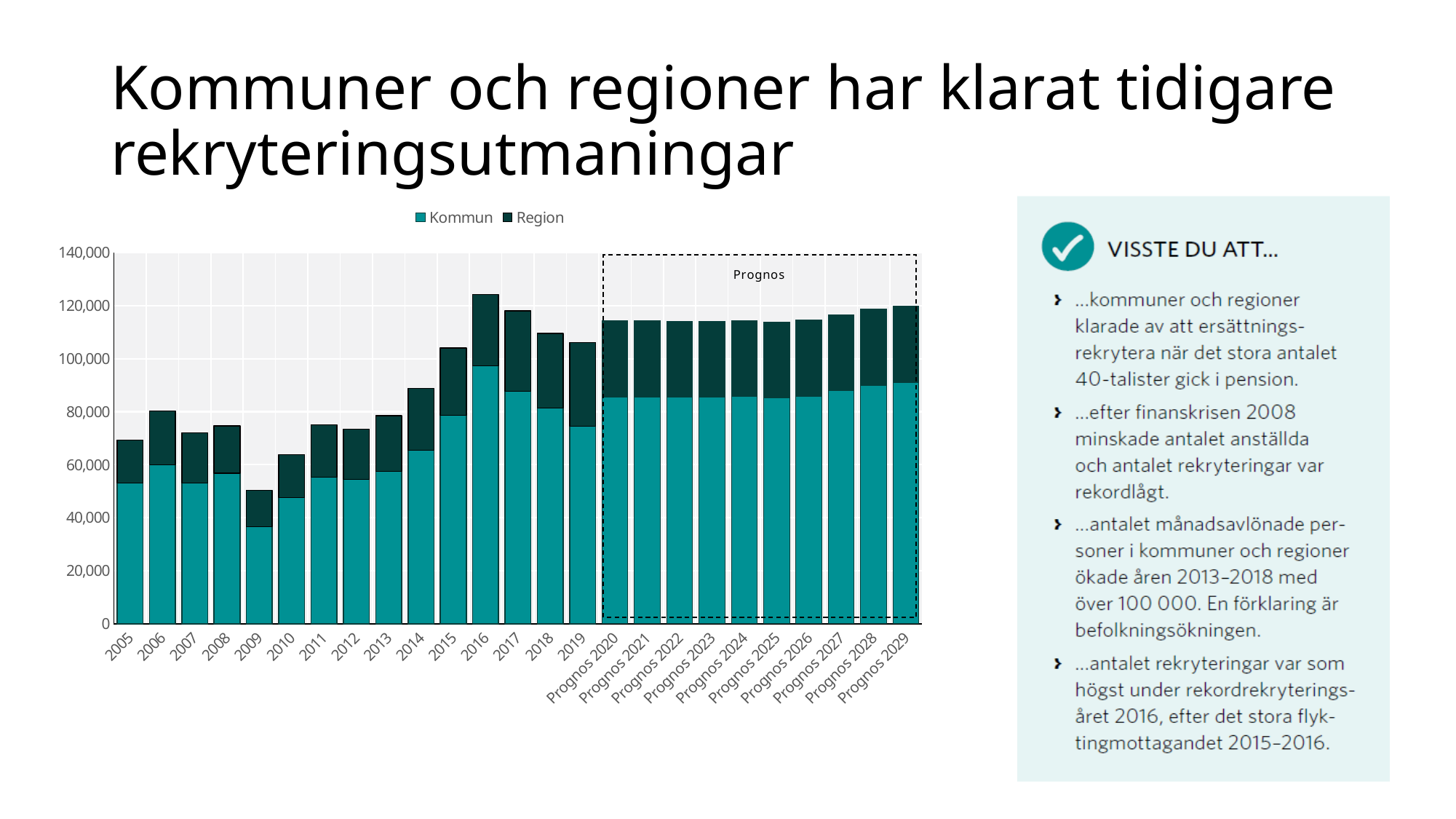
Which year has the highest total bar in the chart? 2016 Do the total bars rise or fall from 2009 to 2016? rise Which year has the lowest total bar in the chart? 2009 Is the total value for 2009 greater or less than 60,000? less Is the Kommun value for 2009 greater or less than 40,000? less Which series are listed in the chart legend? Kommun and Region What kind of chart is shown on the slide? Stacked bar chart Which year has the larger total bar, 2016 or 2017? 2016 How many series does the chart legend list? 2 How many bars (years) are shown on the x axis of the chart? 25 Is the total value for 2016 greater or less than 120,000? greater What label appears inside the dashed box around the bars for 2020 to 2029? Prognos